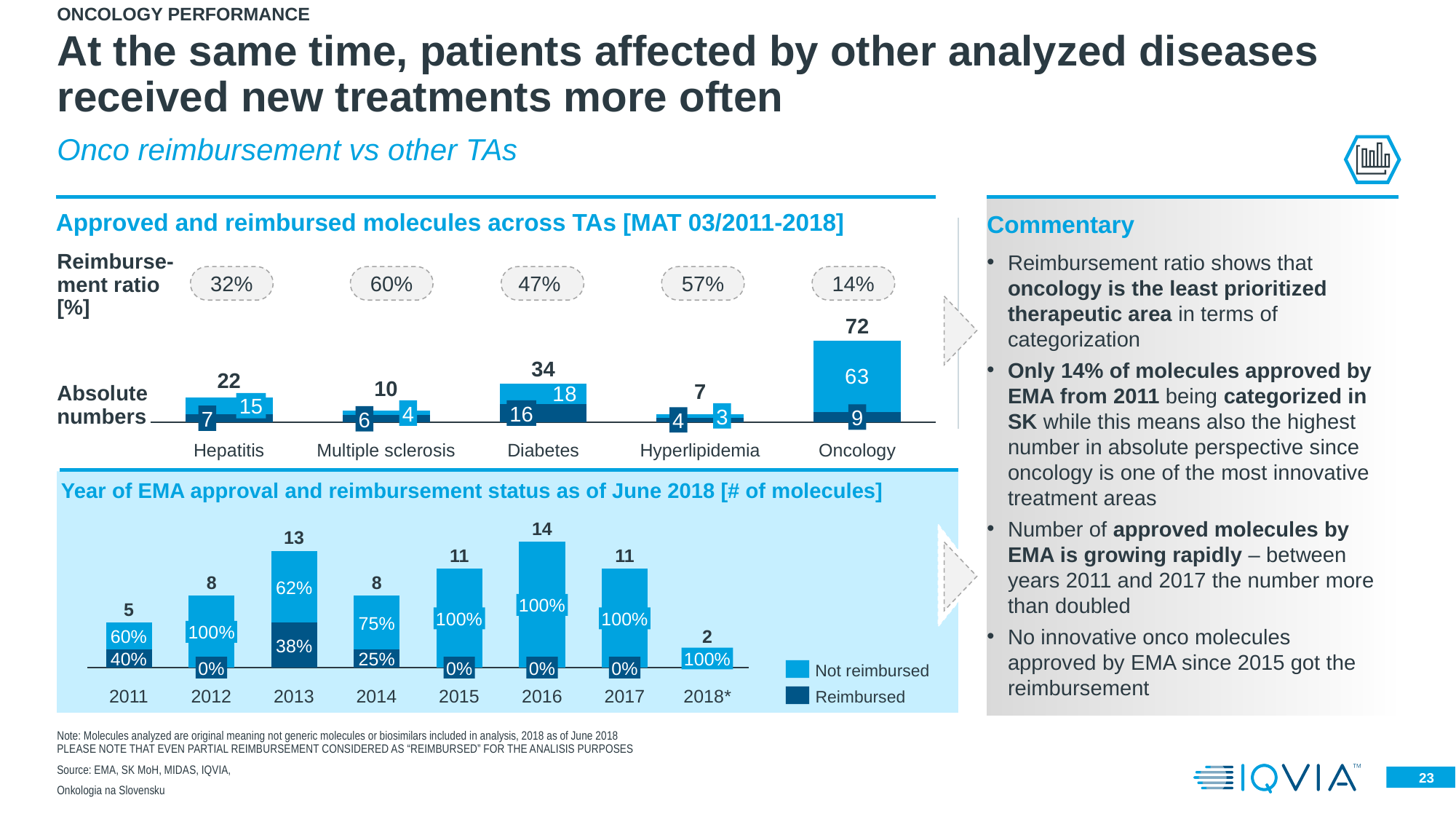
In the 'Approved and reimbursed molecules across TAs' chart, what is the reimbursement ratio shown for Multiple sclerosis? 60% In the 'Approved and reimbursed molecules across TAs' chart, which therapeutic area has the lowest total number of molecules? Hyperlipidemia In the 'Year of EMA approval and reimbursement status' chart, how many series does the legend list? 2 In the 'Approved and reimbursed molecules across TAs' chart, what is the difference between the not reimbursed and reimbursed Oncology molecules? 54 In the 'Year of EMA approval and reimbursement status' chart, is the number of molecules larger in 2013 or in 2015? 2013 In the 'Approved and reimbursed molecules across TAs' chart, how many therapeutic areas are shown? 5 In the 'Year of EMA approval and reimbursement status' chart, which year has the highest number of molecules? 2016 In the 'Approved and reimbursed molecules across TAs' chart, what is the total number of molecules for Oncology? 72 In the 'Year of EMA approval and reimbursement status' chart, what share of the 2013 molecules is reimbursed? 38% In the 'Approved and reimbursed molecules across TAs' chart, which therapeutic area has the lowest reimbursement ratio? Oncology In the 'Year of EMA approval and reimbursement status' chart, how many molecules were approved in 2016? 14 In the 'Approved and reimbursed molecules across TAs' chart, how many Diabetes molecules are reimbursed? 16